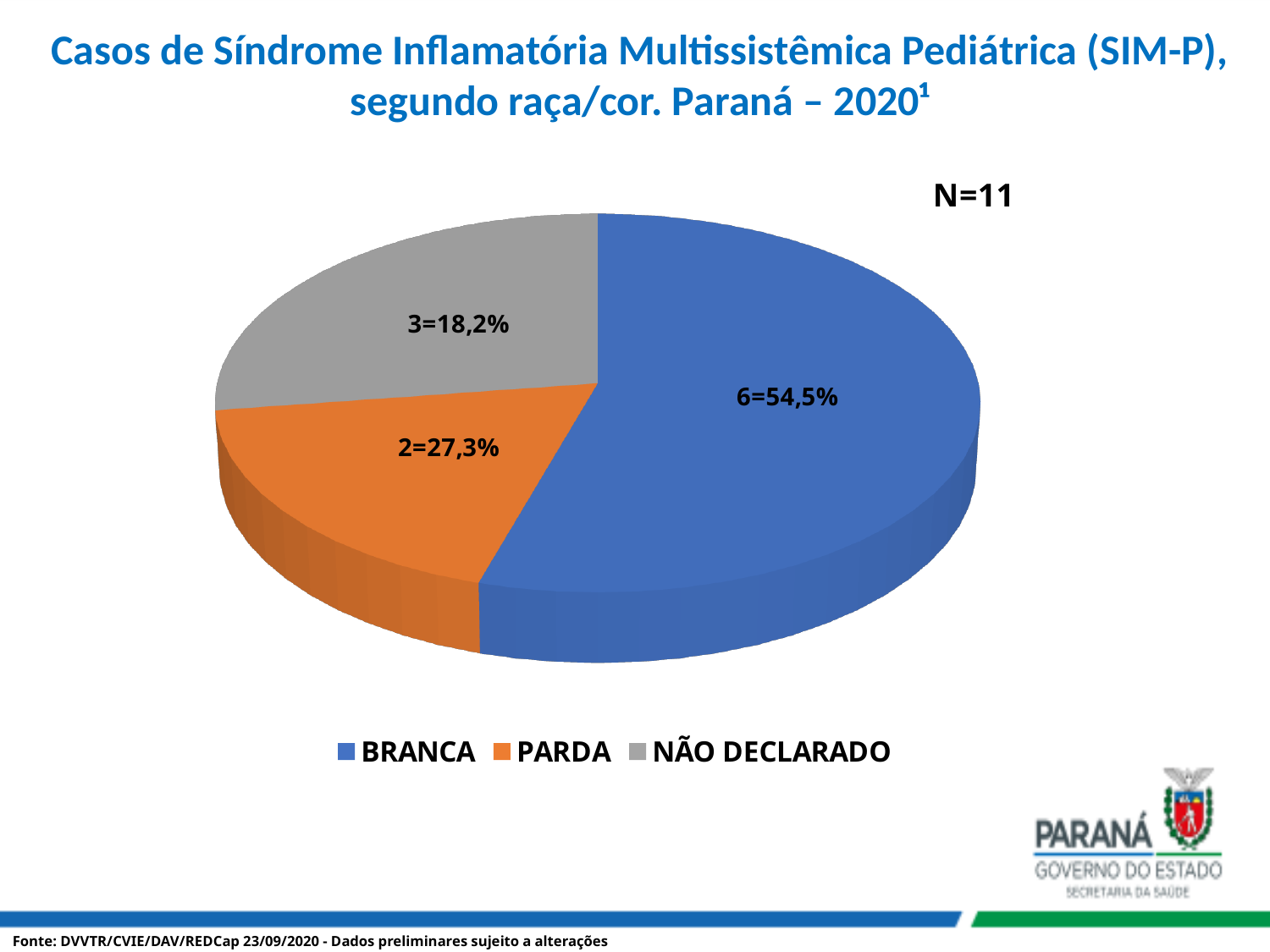
How many cases are shown for BRANCA? 6 How many categories does the legend list? 3 What is the total number of cases (N) shown on the slide? 11 Which category has the smallest slice of the pie? PARDA What share of the pie does BRANCA represent? 54,5% What percentage of cases is labelled for PARDA? 27,3% What colour is the slice for NÃO DECLARADO? grey Which has more cases, PARDA or NÃO DECLARADO? NÃO DECLARADO What type of chart is shown on the slide? pie chart What is the difference in number of cases between BRANCA and PARDA? 4 Which category has the largest slice of the pie? BRANCA How many cases are shown for NÃO DECLARADO? 3